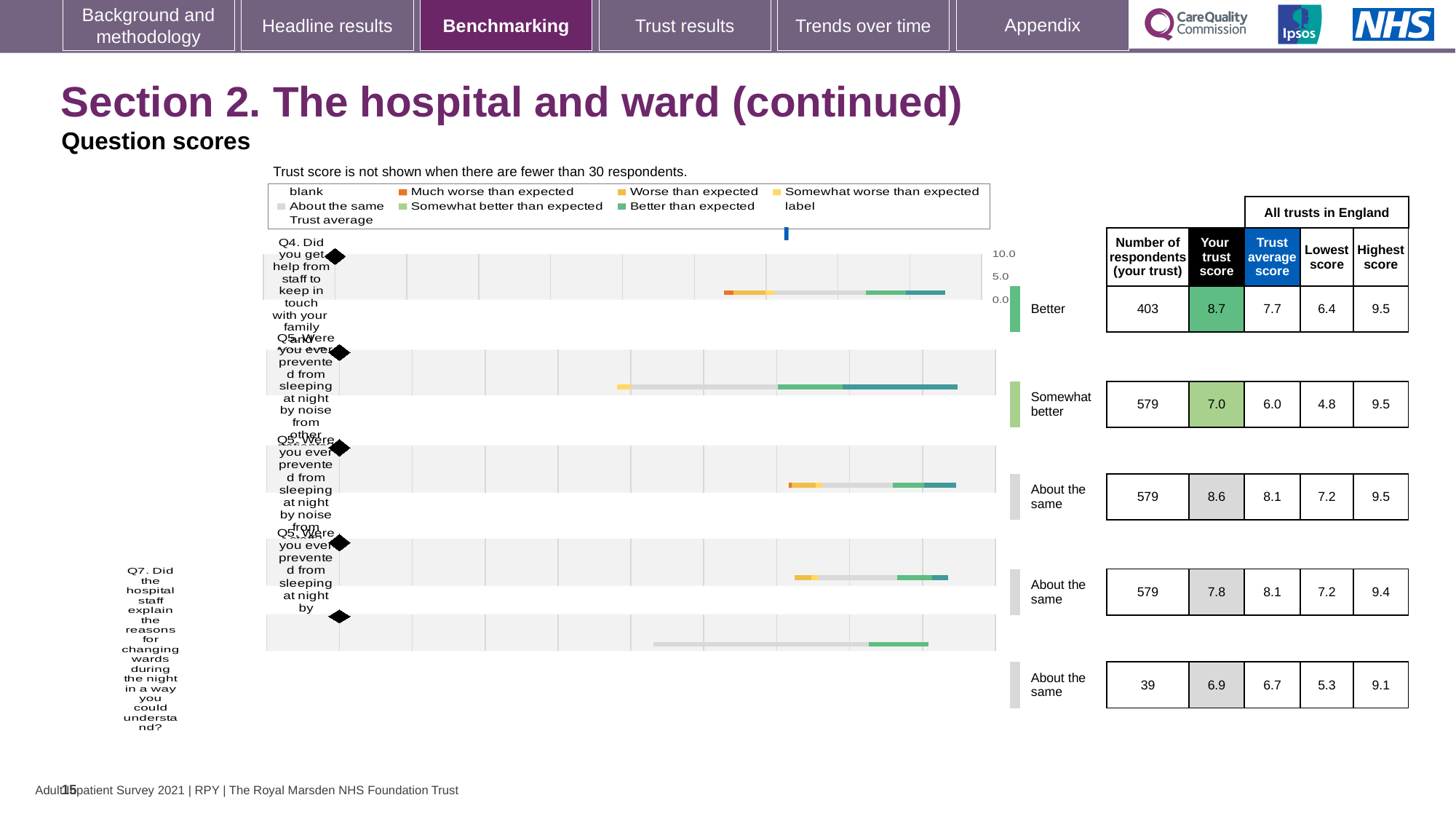
What benchmark category label is shown next to the first row (Q4)? Better How many respondents are shown for Q4 (the first row)? 403 How many question rows are plotted in the chart? 5 Which row has the highest 'Your trust score'? Q4 (first row), 8.7 What is the 'Your trust score' for Q4 (the first row of the chart)? 8.7 What is the highest score across all trusts in England for the second row? 9.5 Which row has the lowest 'Your trust score'? Q7 (last row), 6.9 What kind of chart is used to show the question scores on this slide? bar chart For the second row, which is larger: the trust score or the trust average score? the trust score (7.0) What is the 'Your trust score' for Q7 (the last row of the chart)? 6.9 How many respondents are shown for Q7 (the last row)? 39 For Q4 (the first row), what is the difference between the trust score (8.7) and the trust average score (7.7)? 1.0